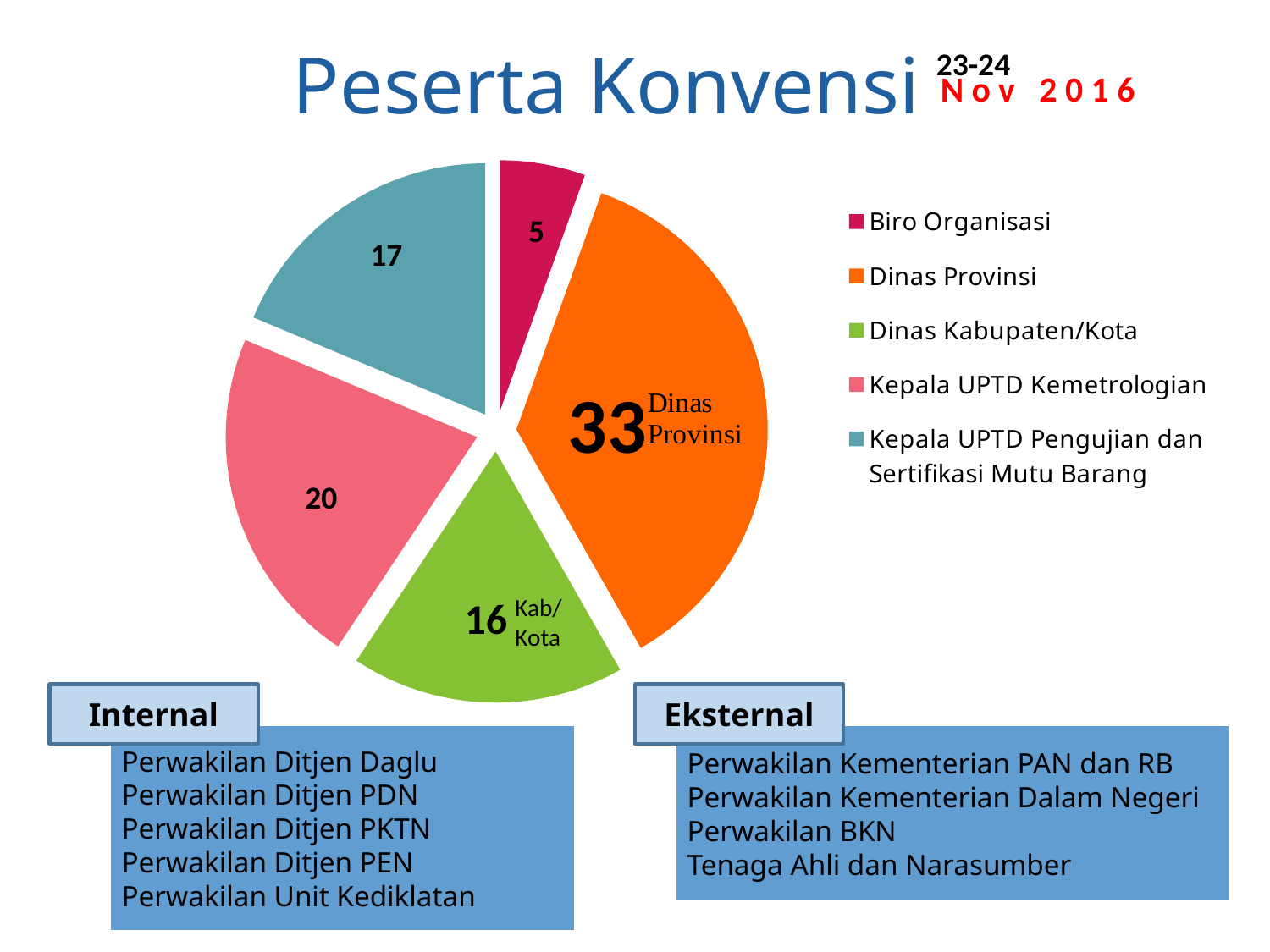
Which category has the smallest slice in the pie chart? Biro Organisasi Which category has the largest slice in the pie chart? Dinas Provinsi How many slices does the pie chart have? 5 What is the value for Dinas Provinsi in the pie chart? 33 What is the value for Biro Organisasi in the pie chart? 5 What colour is the Dinas Provinsi slice in the pie chart? orange What is the value for Kepala UPTD Pengujian dan Sertifikasi Mutu Barang in the pie chart? 17 Which is larger: Kepala UPTD Kemetrologian or Kepala UPTD Pengujian dan Sertifikasi Mutu Barang? Kepala UPTD Kemetrologian What is the difference between the values for Dinas Provinsi and Kepala UPTD Kemetrologian? 13 What is the value for Kepala UPTD Kemetrologian in the pie chart? 20 What is the value for Dinas Kabupaten/Kota in the pie chart? 16 What kind of chart is shown on the slide? pie chart